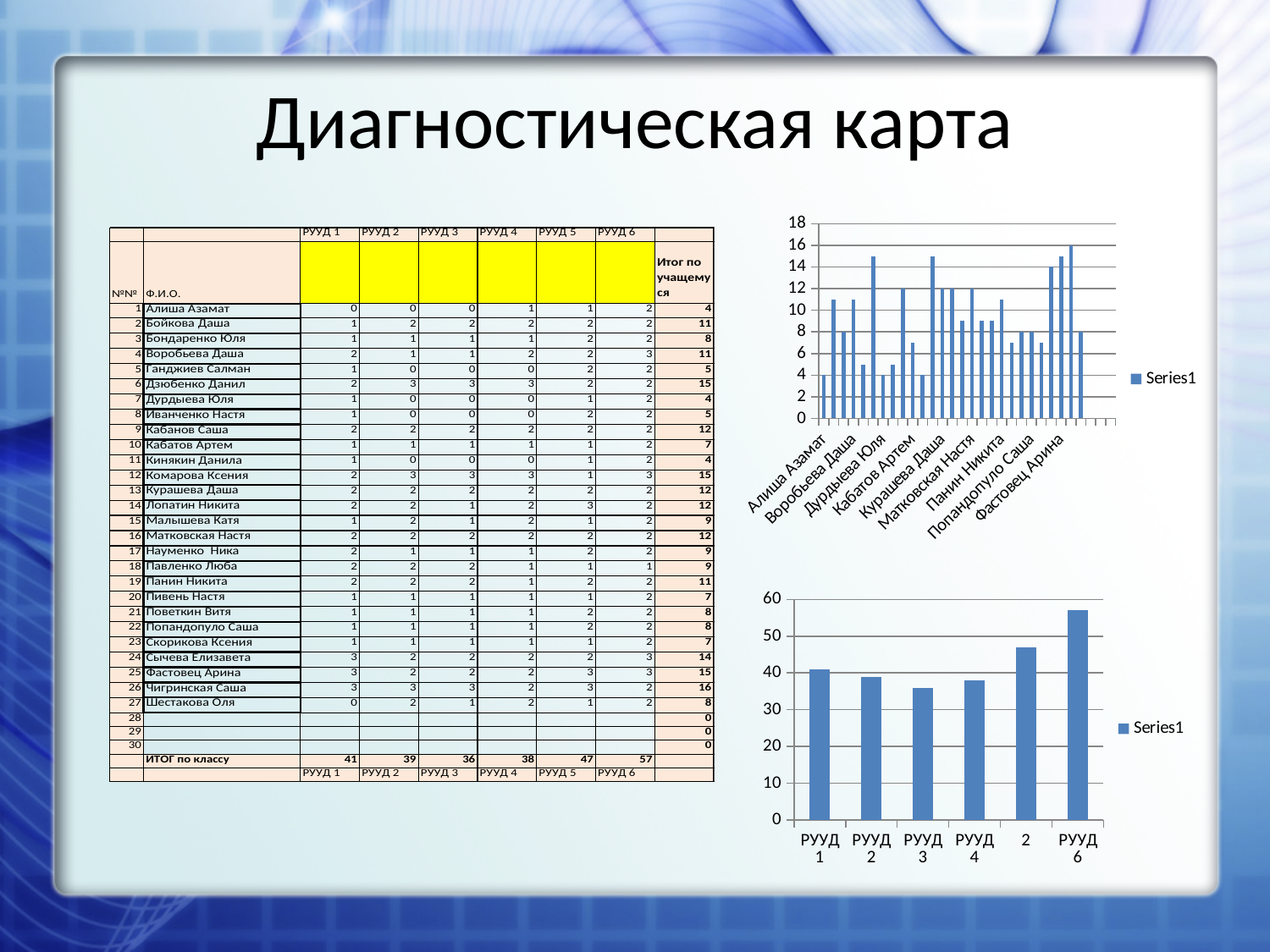
In the top-right chart, is the value for Кабатов Артем greater or less than 8? less In the top-right chart, is the value for Фастовец Арина greater or less than 14? greater In the bottom-right chart, is the value for РУУД 6 greater or less than 50? greater In the top-right chart, what is the value for Алиша Азамат? 4 In the bottom-right chart, which is larger, the value for РУУД 1 or the value for РУУД 6? РУУД 6 In the bottom-right chart, which category has the highest bar? РУУД 6 What kind of chart is the bottom-right chart with categories РУУД 1 to РУУД 6? bar chart How many bars are plotted in the bottom-right chart? 6 How many series does the legend of the bottom-right chart list? 1 What is the legend entry shown for the top-right chart? Series1 In the top-right chart, what is the value for Курашева Даша? 12